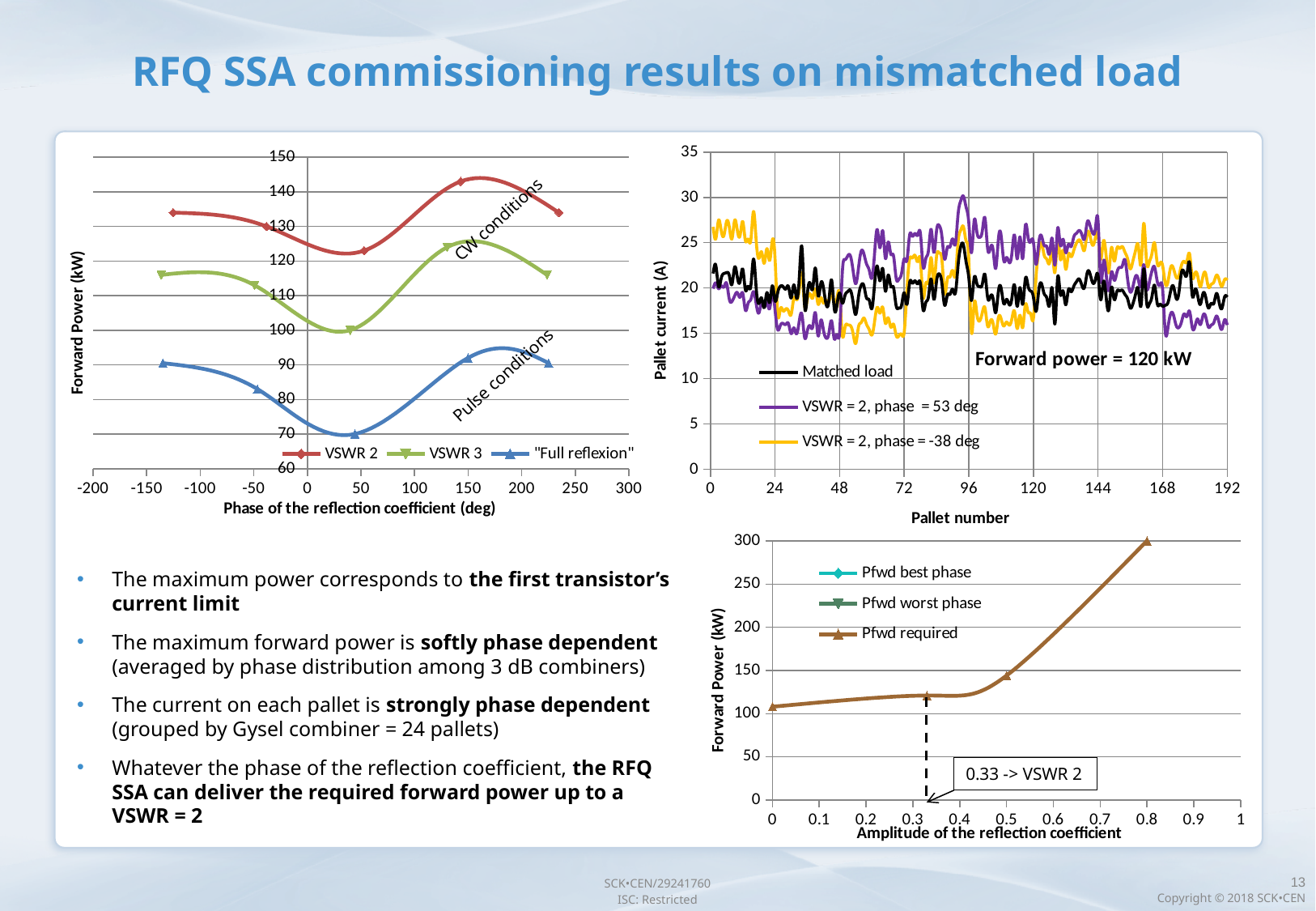
In the top-right chart (Pallet current vs Pallet number), how many series does the legend list? 3 In the top-right chart (Pallet current vs Pallet number), what forward power is stated in the annotation? 120 kW In the left chart (Forward Power vs Phase of the reflection coefficient), which series has the lowest forward power values? "Full reflexion" In the bottom-right chart (Forward Power vs Amplitude of the reflection coefficient), what is the Pfwd required value at an amplitude of 0.8? 300 In the left chart (Forward Power vs Phase of the reflection coefficient), is the VSWR 3 value at a phase of -50 deg greater or less than 120? less In the bottom-right chart (Forward Power vs Amplitude of the reflection coefficient), does the Pfwd required curve rise or fall as the amplitude increases? rise In the left chart (Forward Power vs Phase of the reflection coefficient), which series has the highest forward power values? VSWR 2 In the top-right chart (Pallet current vs Pallet number), is the peak of the VSWR = 2, phase = 53 deg series near pallet 96 greater or less than 25? greater In the bottom-right chart (Forward Power vs Amplitude of the reflection coefficient), is the Pfwd required value at an amplitude of 0.5 greater or less than 200? less In the left chart (Forward Power vs Phase of the reflection coefficient), how many series does the legend list? 3 What kind of chart is the left chart showing Forward Power versus Phase of the reflection coefficient? line chart